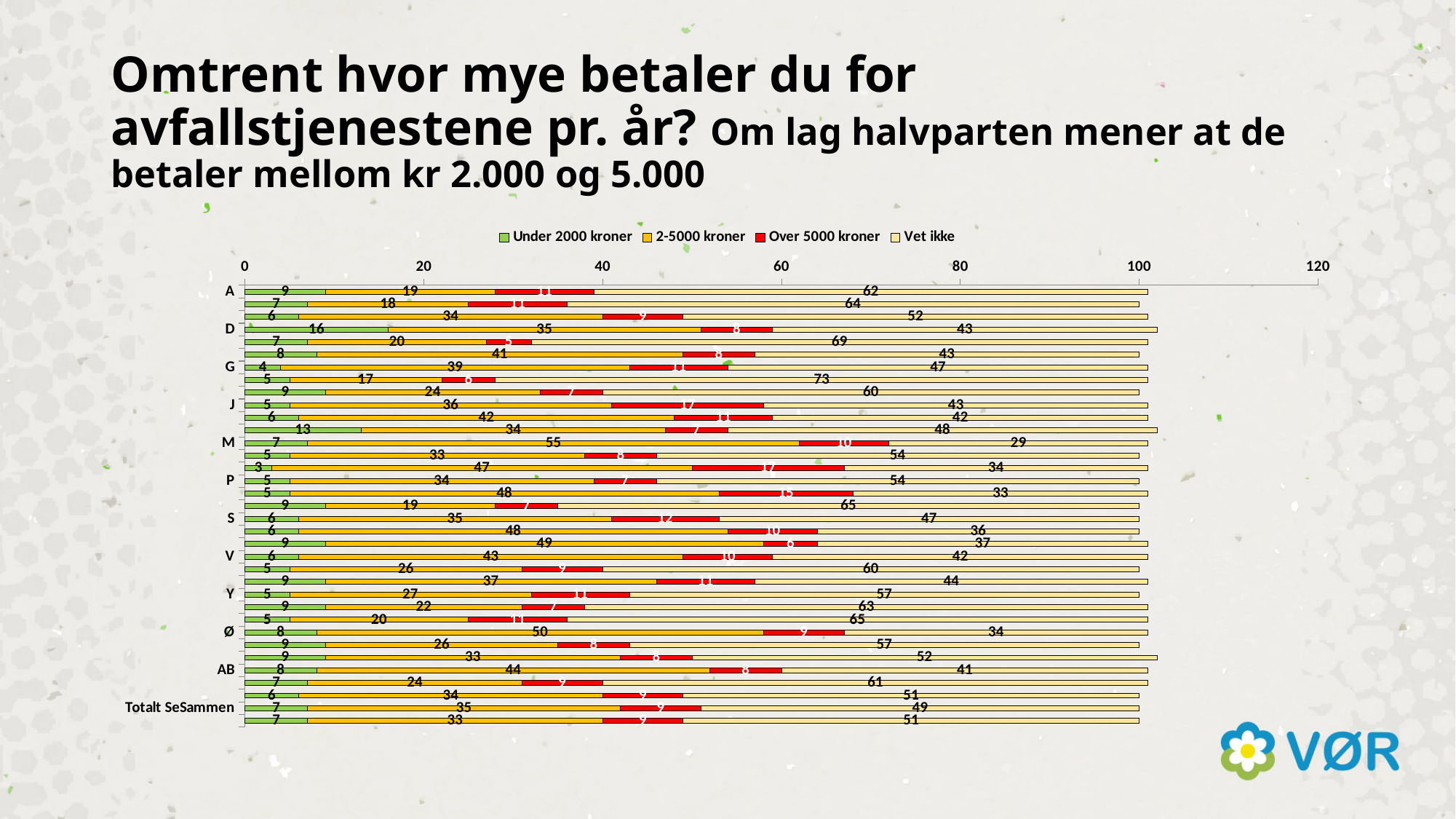
What kind of chart is shown on the slide? bar chart What is the value of 'Over 5000 kroner' for category J? 17 How many series does the legend list? 4 Which has a larger '2-5000 kroner' value, category Ø or category Y? Ø What is the value of 'Vet ikke' for 'Totalt SeSammen'? 49 What are the four legend entries of the chart? Under 2000 kroner, 2-5000 kroner, Over 5000 kroner, Vet ikke What is the value of 'Vet ikke' for category D? 43 What is the difference between the 'Vet ikke' values for category Y and category M? 28 What is the value of 'Under 2000 kroner' for category G? 4 What is the value of '2-5000 kroner' for category M? 55 Among the labeled categories, which has the highest '2-5000 kroner' value? M What is the value of 'Under 2000 kroner' for category D? 16